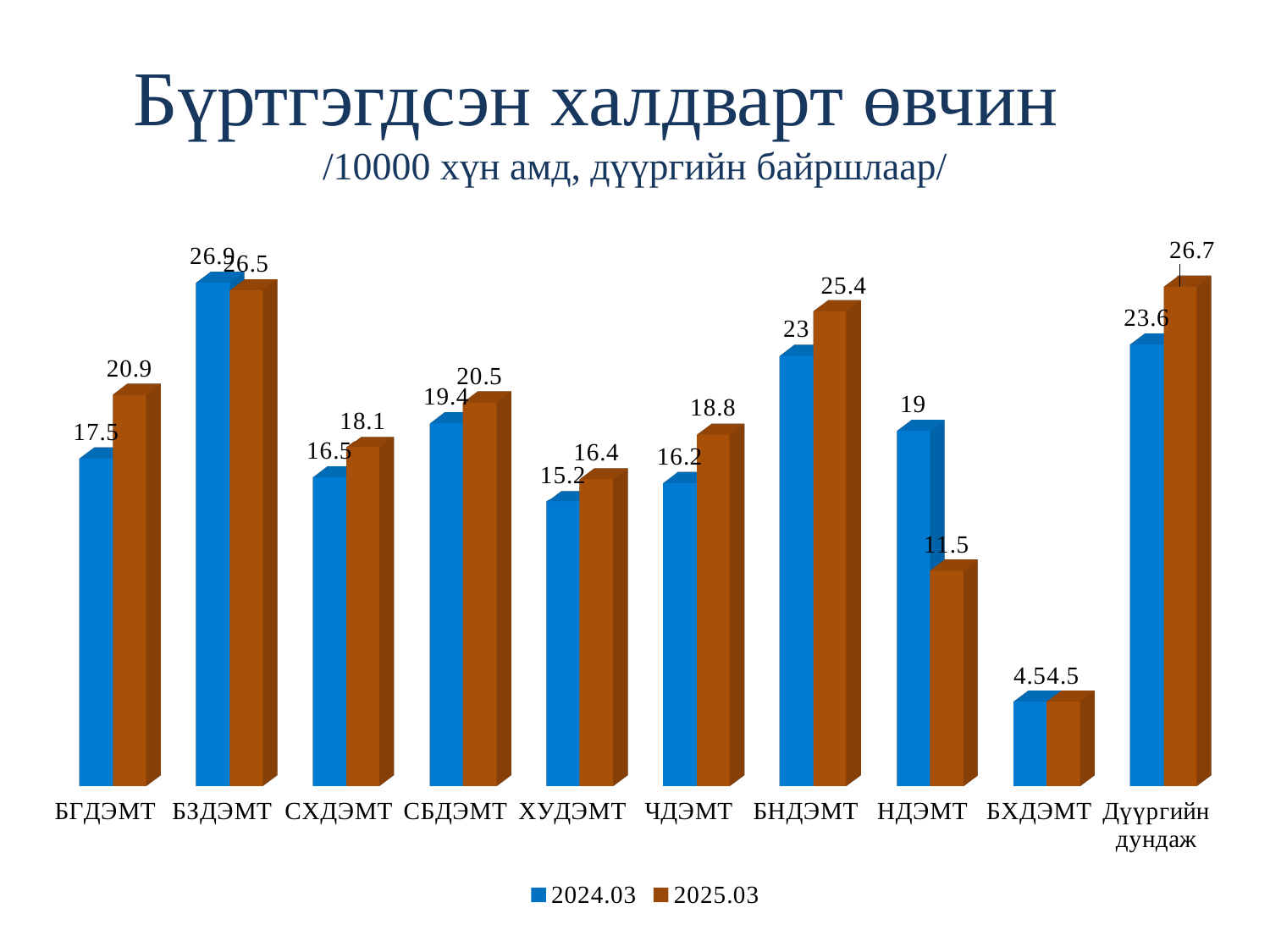
How many categories are shown on the x axis? 10 Which category has the highest value in the 2024.03 series? БЗДЭМТ What is the value for БНДЭМТ in the 2024.03 series? 23 What is the value for БГДЭМТ in the 2025.03 series? 20.9 How many series does the legend list? 2 What kind of chart is shown on the slide? Bar chart What is the value for НДЭМТ in the 2025.03 series? 11.5 What are the two series named in the legend? 2024.03 and 2025.03 Which category has the lowest value in the 2025.03 series? БХДЭМТ What is the 2024.03 value for Дүүргийн дундаж? 23.6 What is the difference between the 2024.03 and 2025.03 values for НДЭМТ? 7.5 For ЧДЭМТ, which series has the larger value, 2024.03 or 2025.03? 2025.03